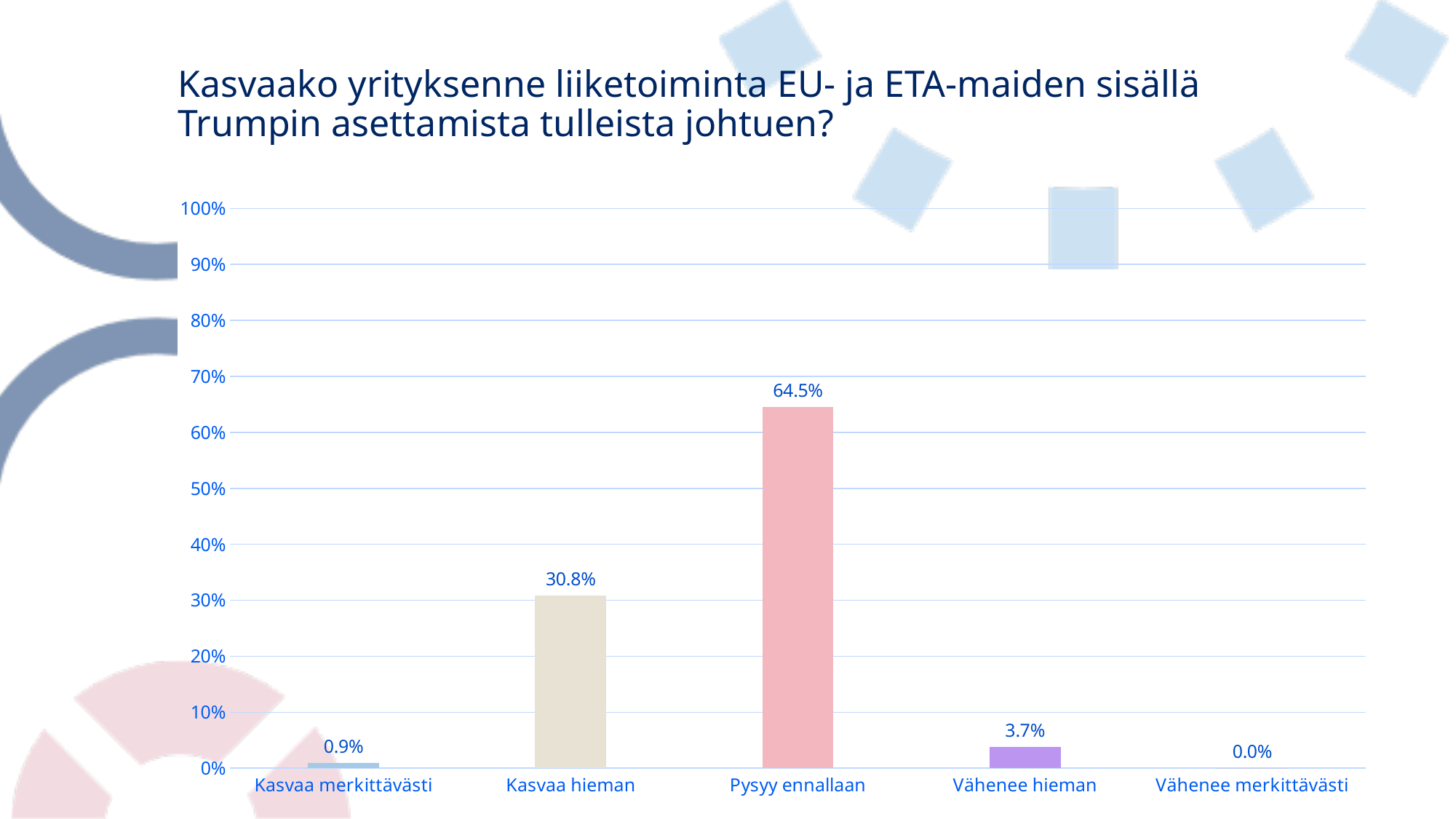
Which category has the highest value? Pysyy ennallaan Which category has the lowest value? Vähenee merkittävästi Which is larger, the value for Vähenee hieman or the value for Kasvaa merkittävästi? Vähenee hieman What is the difference between the values for Pysyy ennallaan and Kasvaa hieman? 33.7% What is the value for Kasvaa hieman? 30.8% What is the value for Vähenee hieman? 3.7% What is the value for Pysyy ennallaan? 64.5% How many categories are shown on the x axis? 5 Is the value for Pysyy ennallaan greater or less than 60%? greater What is the value for Vähenee merkittävästi? 0.0% What is the value for Kasvaa merkittävästi? 0.9% What kind of chart is shown on the slide? bar chart